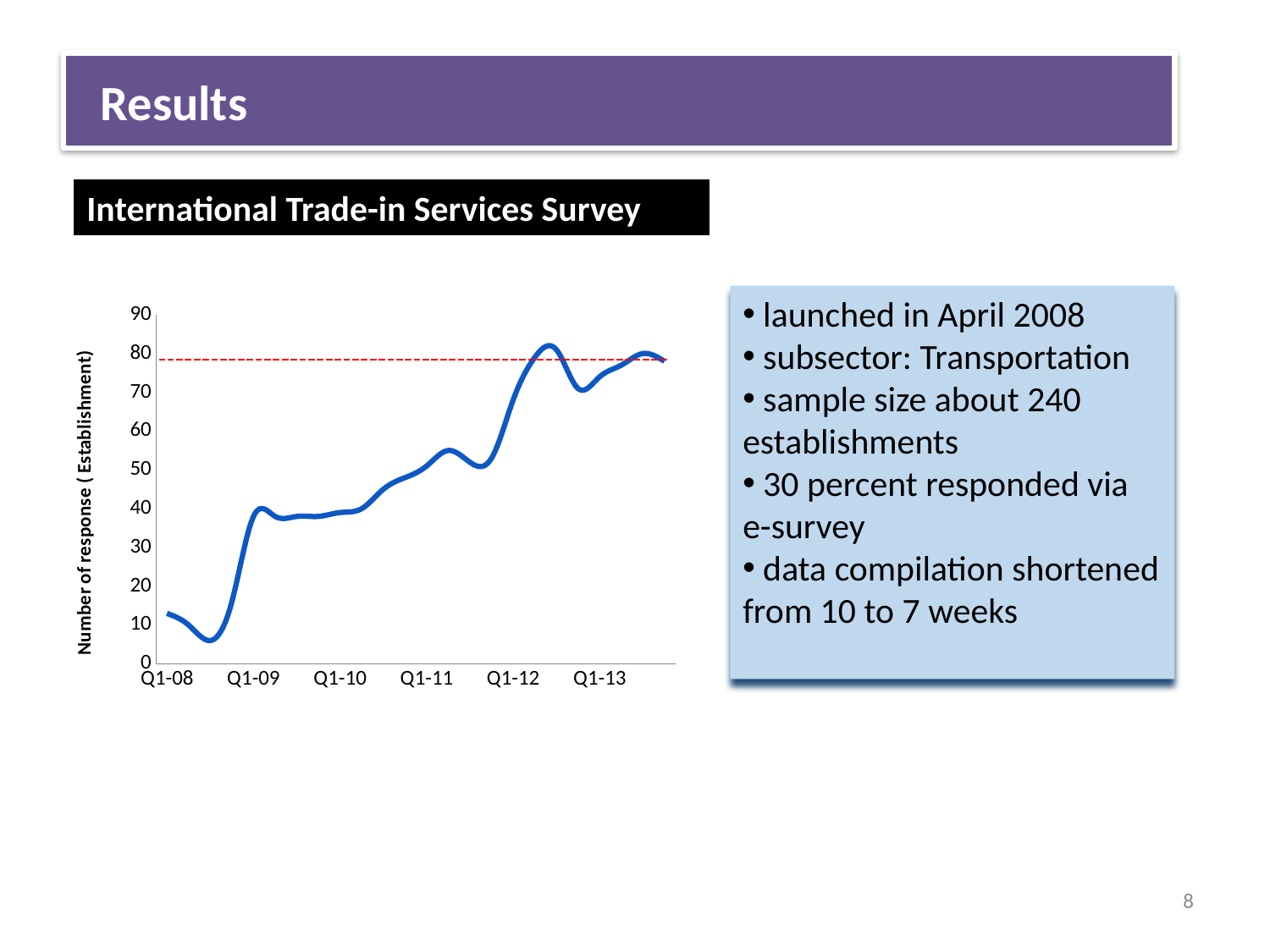
Is the value at Q1-09 greater or less than 50? less Is the value at Q1-10 greater or less than 50? less Is the value at Q1-11 greater or less than 40? greater Overall, do the values rise or fall from Q1-08 to Q1-13? rise What is the label of the y axis? Number of response ( Establishment) How many labels are shown on the x axis? 6 Is the value at Q1-12 greater or less than the value at Q1-09? greater What is the highest value shown on the y axis? 90 What kind of chart is shown on the slide? line chart